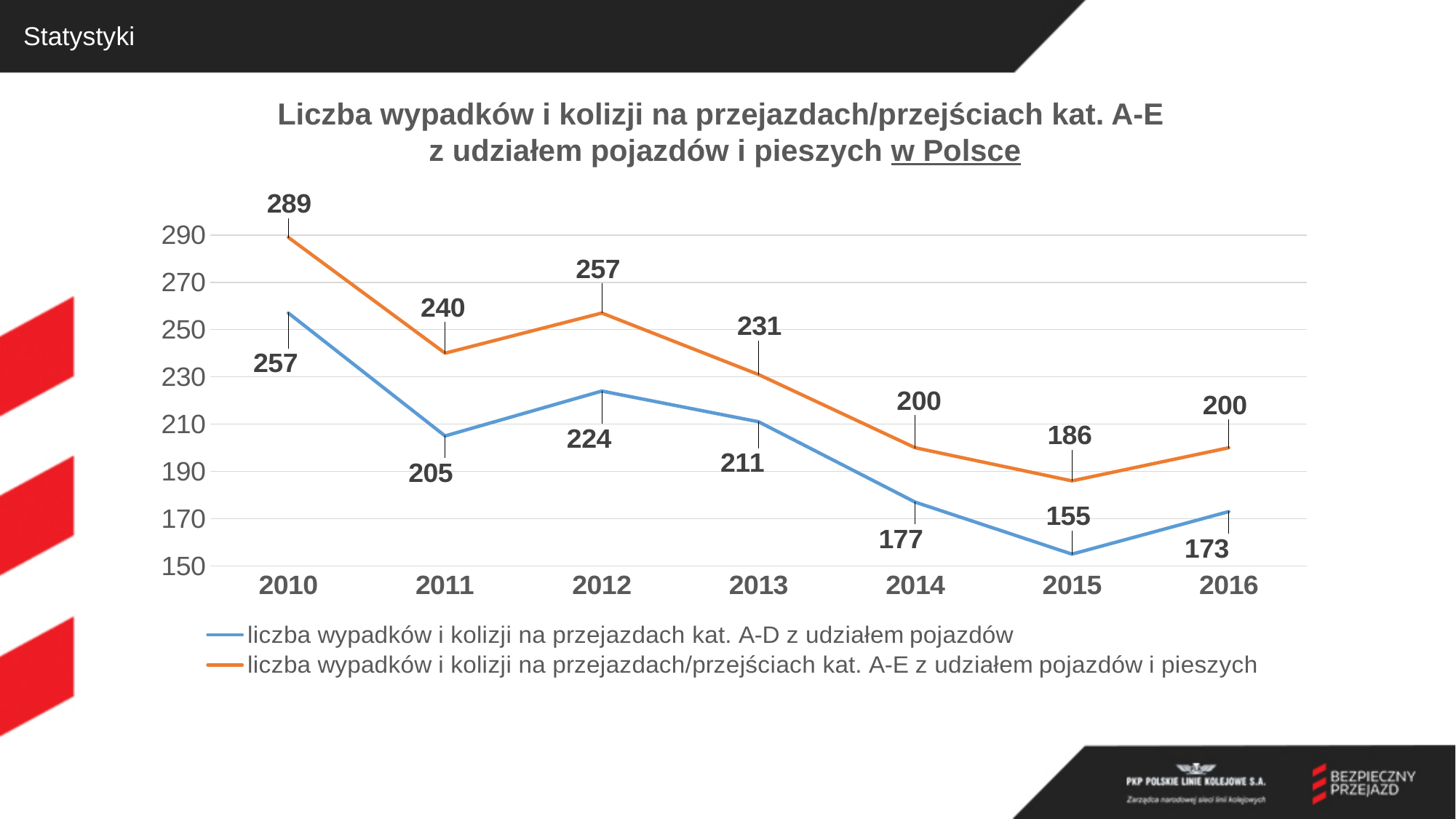
In which year is the series 'liczba wypadków i kolizji na przejazdach/przejściach kat. A-E z udziałem pojazdów i pieszych' highest? 2010 What is the difference between the 2012 and 2016 values of the series 'liczba wypadków i kolizji na przejazdach kat. A-D z udziałem pojazdów'? 51 What type of chart is shown on the slide? line chart How many years are plotted on the x axis? 7 What is the value for 2013 in the series 'liczba wypadków i kolizji na przejazdach/przejściach kat. A-E z udziałem pojazdów i pieszych'? 231 In which year is the series 'liczba wypadków i kolizji na przejazdach kat. A-D z udziałem pojazdów' lowest? 2015 How many series does the legend list? 2 What is the value for 2010 in the series 'liczba wypadków i kolizji na przejazdach/przejściach kat. A-E z udziałem pojazdów i pieszych'? 289 What is the difference between the two series in 2010? 32 Overall, do the values of the series 'liczba wypadków i kolizji na przejazdach kat. A-D z udziałem pojazdów' rise or fall from 2010 to 2015? fall What is the value for 2015 in the series 'liczba wypadków i kolizji na przejazdach kat. A-D z udziałem pojazdów'? 155 Which is larger: the 2014 value or the 2016 value of the series 'liczba wypadków i kolizji na przejazdach/przejściach kat. A-E z udziałem pojazdów i pieszych'? They are equal (200)